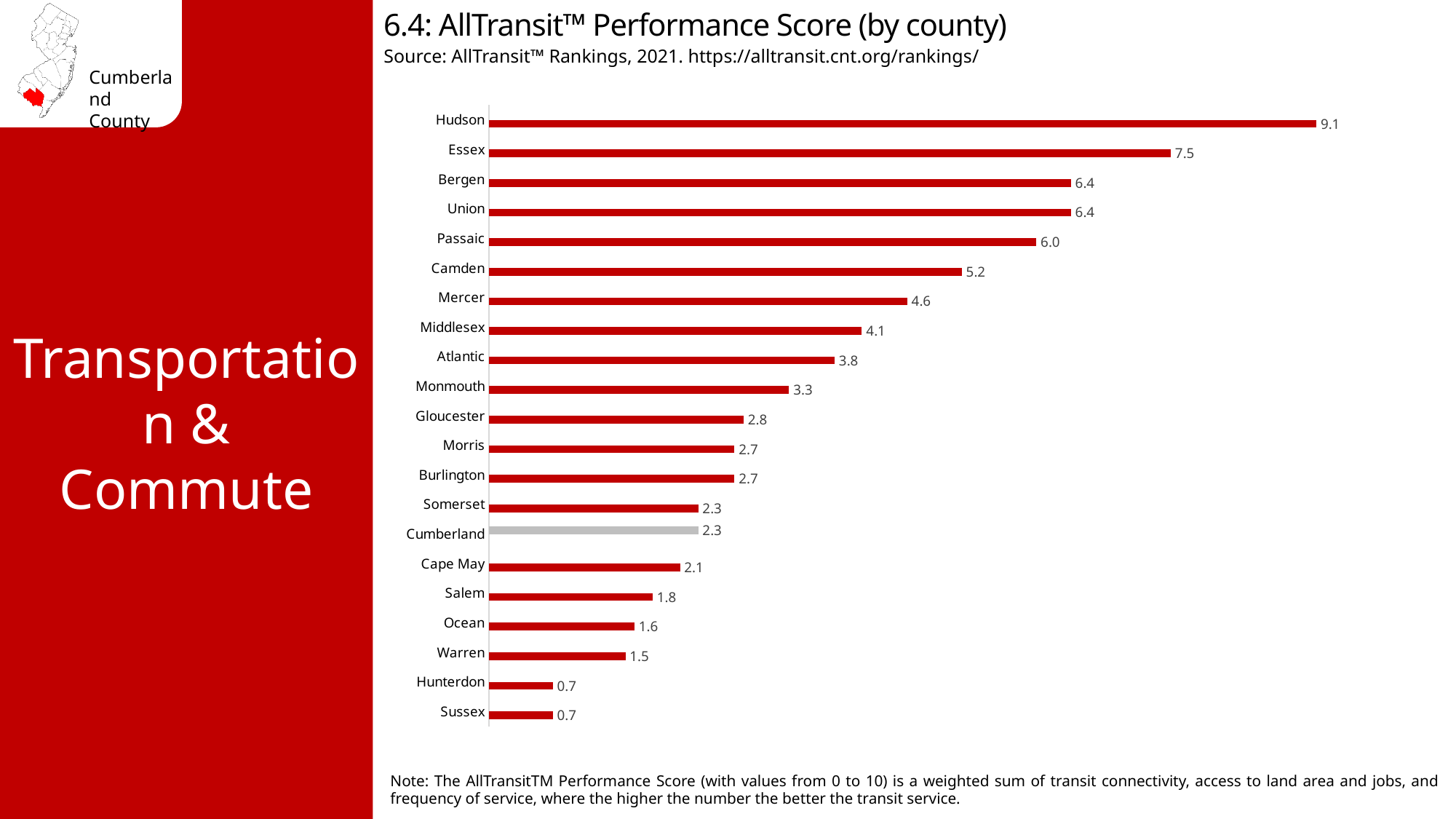
What is the AllTransit Performance Score for Hudson County? 9.1 Which county has a higher AllTransit Performance Score, Salem or Ocean? Salem What type of chart is used to show the AllTransit Performance Score by county? Bar chart What is the AllTransit Performance Score for Cumberland County? 2.3 What is the difference between the AllTransit Performance Scores of Cumberland and Cape May counties? 0.2 What is the difference between the AllTransit Performance Scores of Hudson and Essex counties? 1.6 Which county has the highest AllTransit Performance Score? Hudson Which county has a higher AllTransit Performance Score, Mercer or Middlesex? Mercer What is the AllTransit Performance Score for Passaic County? 6.0 Which county's bar is shown in gray instead of red? Cumberland How many counties are shown in the chart? 21 What is the AllTransit Performance Score for Camden County? 5.2